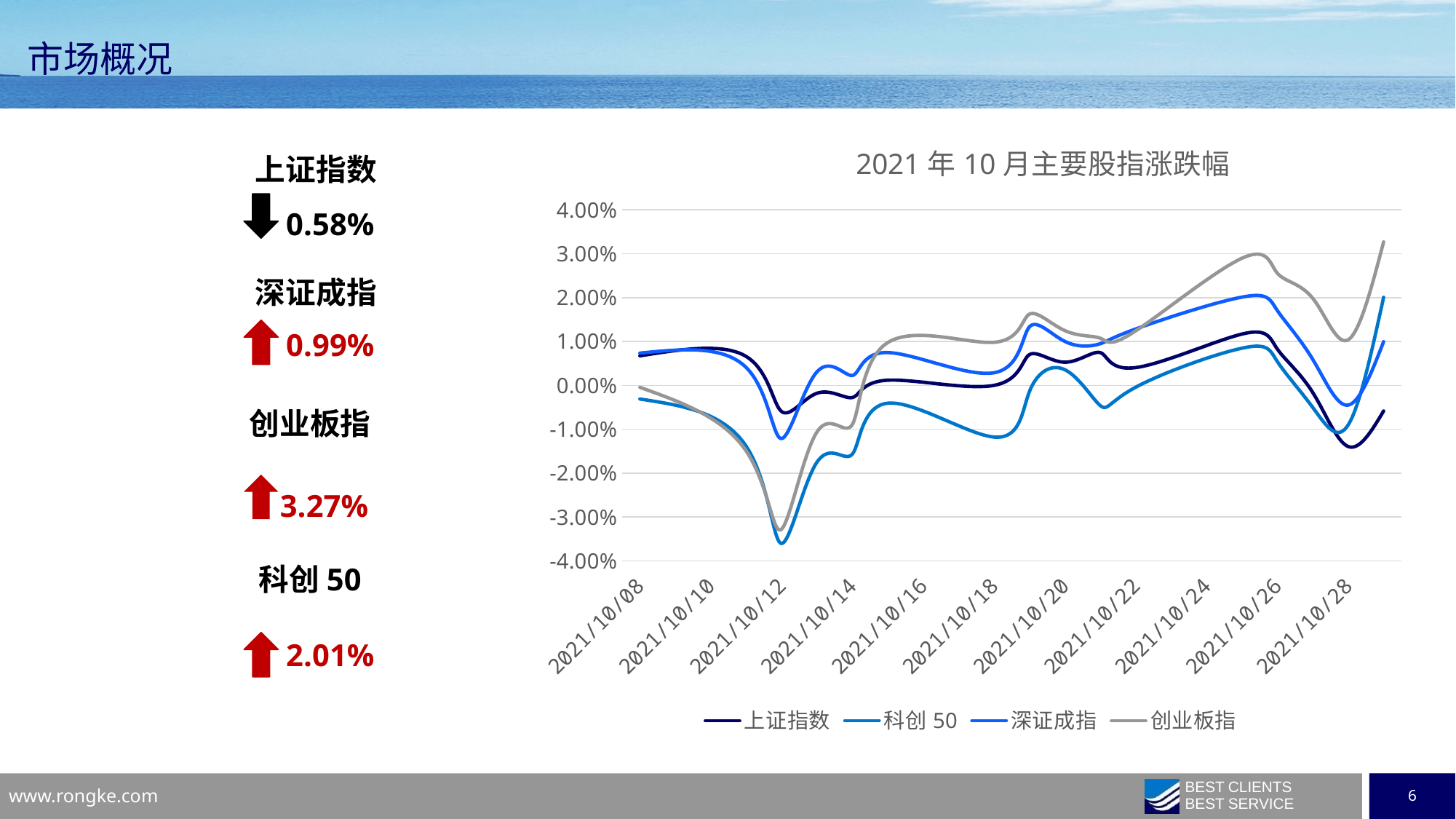
How many date labels are shown on the x axis of the chart? 11 Which series is lowest at the right end of the chart? 上证指数 Is the value for 上证指数 at 2021/10/08 greater or less than 0.00%? greater Is the value for 科创 50 at 2021/10/12 greater or less than -3.00%? less Is the value for 创业板指 at 2021/10/12 greater or less than -2.00%? less At 2021/10/12, which is higher: 上证指数 or 科创 50? 上证指数 Does the 创业板指 line rise or fall between 2021/10/12 and 2021/10/26? rise Which series in the chart is drawn in gray? 创业板指 Which series is highest at the right end of the chart? 创业板指 How many series does the chart legend list? 4 What is the title of the chart? 2021 年 10 月主要股指涨跌幅 What kind of chart is shown on the slide? line chart